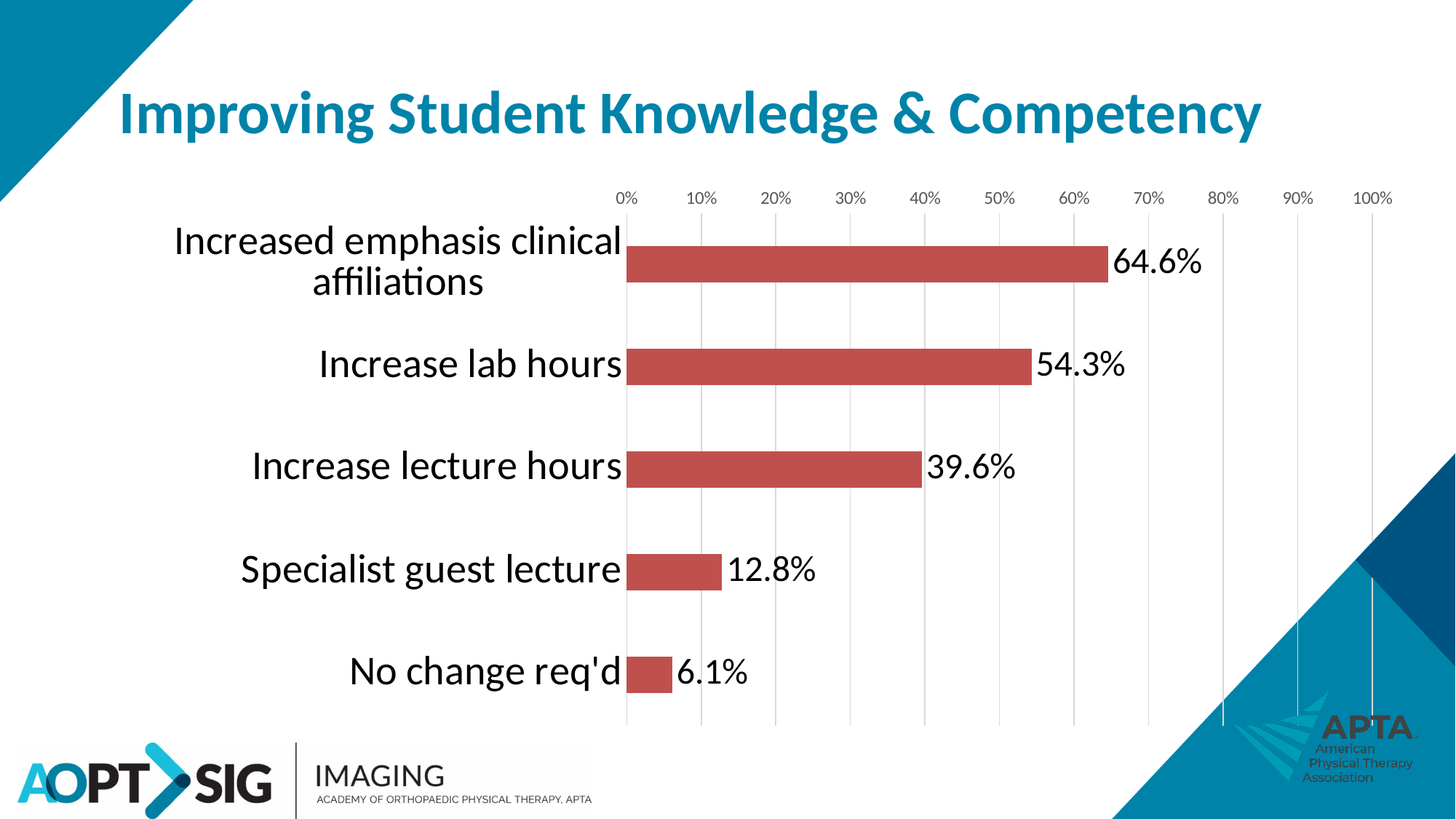
What kind of chart is shown on the slide? bar chart What is the difference between the values for Increase lab hours and Increase lecture hours? 14.7% Which category has the lowest value? No change req'd Which is larger, the value for Increase lecture hours or the value for Specialist guest lecture? Increase lecture hours What is the value for Specialist guest lecture? 12.8% Which category has the highest value? Increased emphasis clinical affiliations How many categories are shown in the chart? 5 What is the value for No change req'd? 6.1% What is the title of the slide? Improving Student Knowledge & Competency What is the value for Increased emphasis clinical affiliations? 64.6% Is the value for Increase lecture hours greater or less than 50%? less What is the value for Increase lab hours? 54.3%